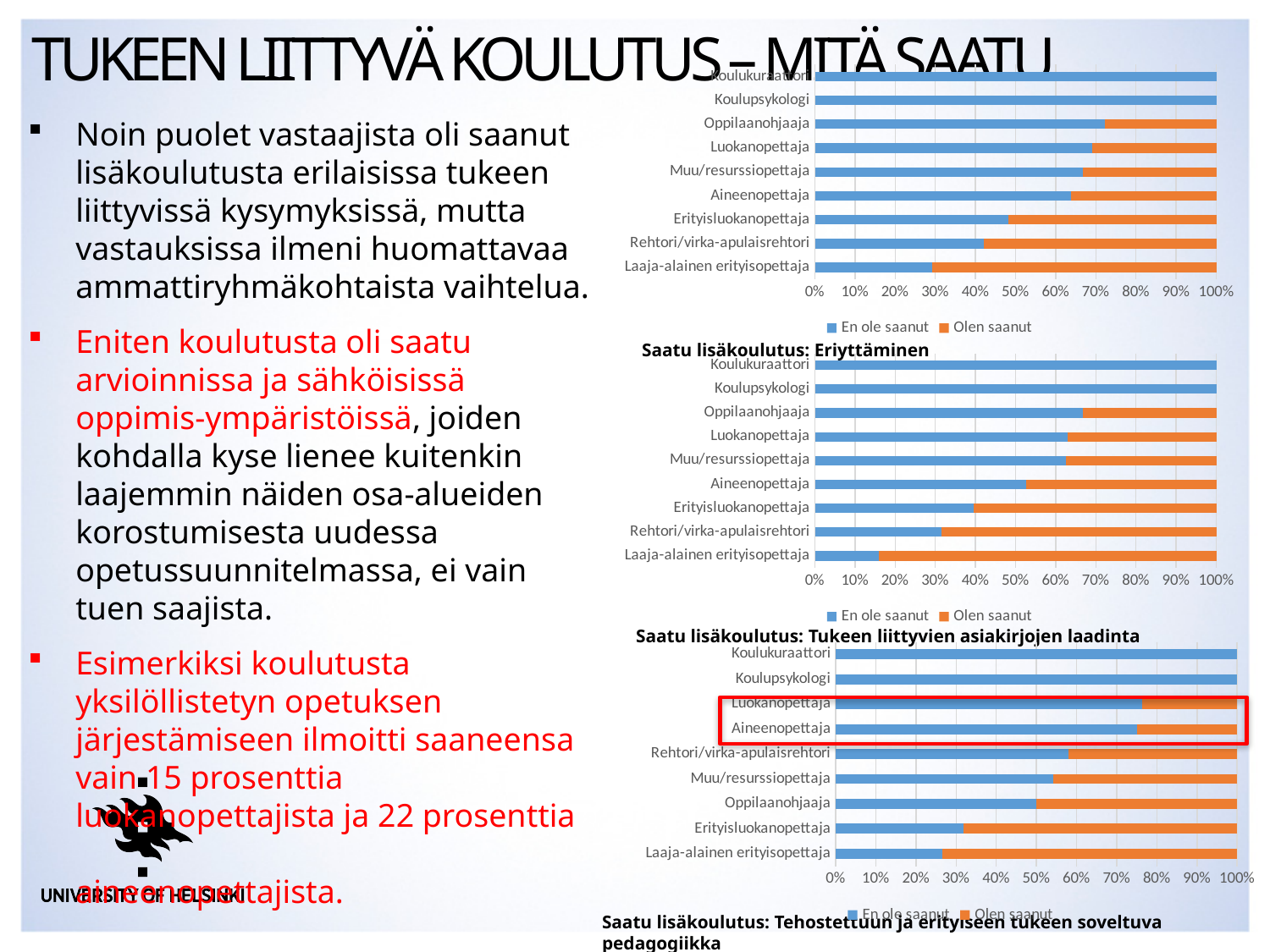
In the bottom chart, is the 'En ole saanut' value for Luokanopettaja greater or less than 70%? greater What are the two legend entries of the middle chart? En ole saanut, Olen saanut In the middle chart, which category has the largest 'Olen saanut' share? Laaja-alainen erityisopettaja How many professional groups (categories) are shown in the bottom chart? 9 In the top chart, which category has the largest 'Olen saanut' share? Laaja-alainen erityisopettaja What type of chart is the top chart on the slide? Stacked bar chart In the top chart, which has the larger 'En ole saanut' share: Oppilaanohjaaja or Erityisluokanopettaja? Oppilaanohjaaja In the bottom chart, is the 'En ole saanut' value for Erityisluokanopettaja greater or less than 40%? less In the top chart, is the 'En ole saanut' value for Laaja-alainen erityisopettaja greater or less than 40%? less How many series does the legend of the top chart list? 2